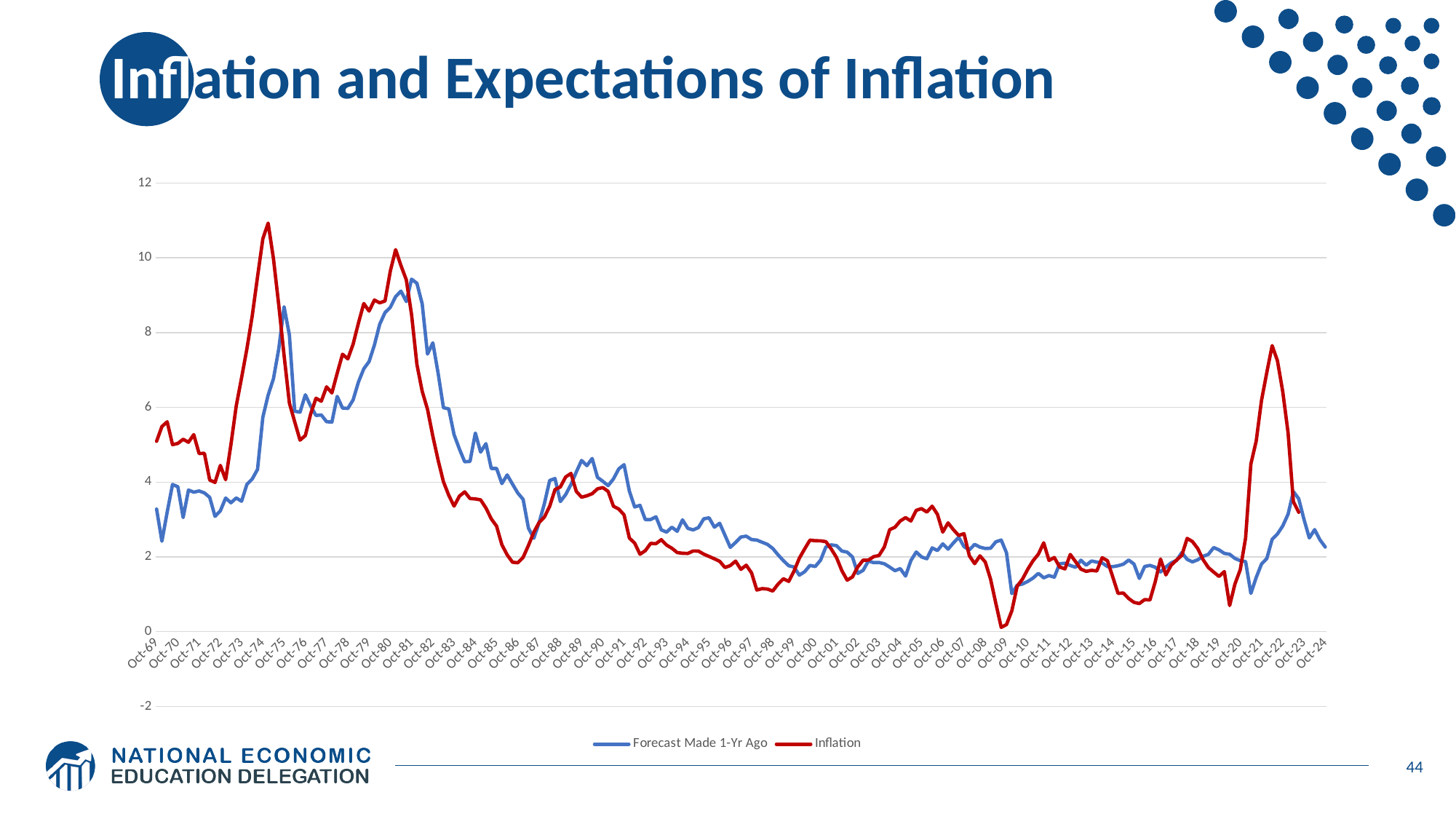
What kind of chart is shown on the slide? line chart What are the two series named in the legend? Forecast Made 1-Yr Ago and Inflation Which series is drawn in red? Inflation How many series does the legend list? 2 Is the Forecast Made 1-Yr Ago value at Oct-81 greater or less than 8? greater At Oct-22, which series is higher, Inflation or Forecast Made 1-Yr Ago? Inflation Which series reaches the highest value anywhere on the chart? Inflation Does the Inflation series ever rise above 10 on the chart? yes Is the Forecast Made 1-Yr Ago value at Oct-24 greater or less than 4? less At Oct-86, which series is higher, Inflation or Forecast Made 1-Yr Ago? Forecast Made 1-Yr Ago Between Oct-81 and Oct-86, does the Inflation series rise or fall? fall